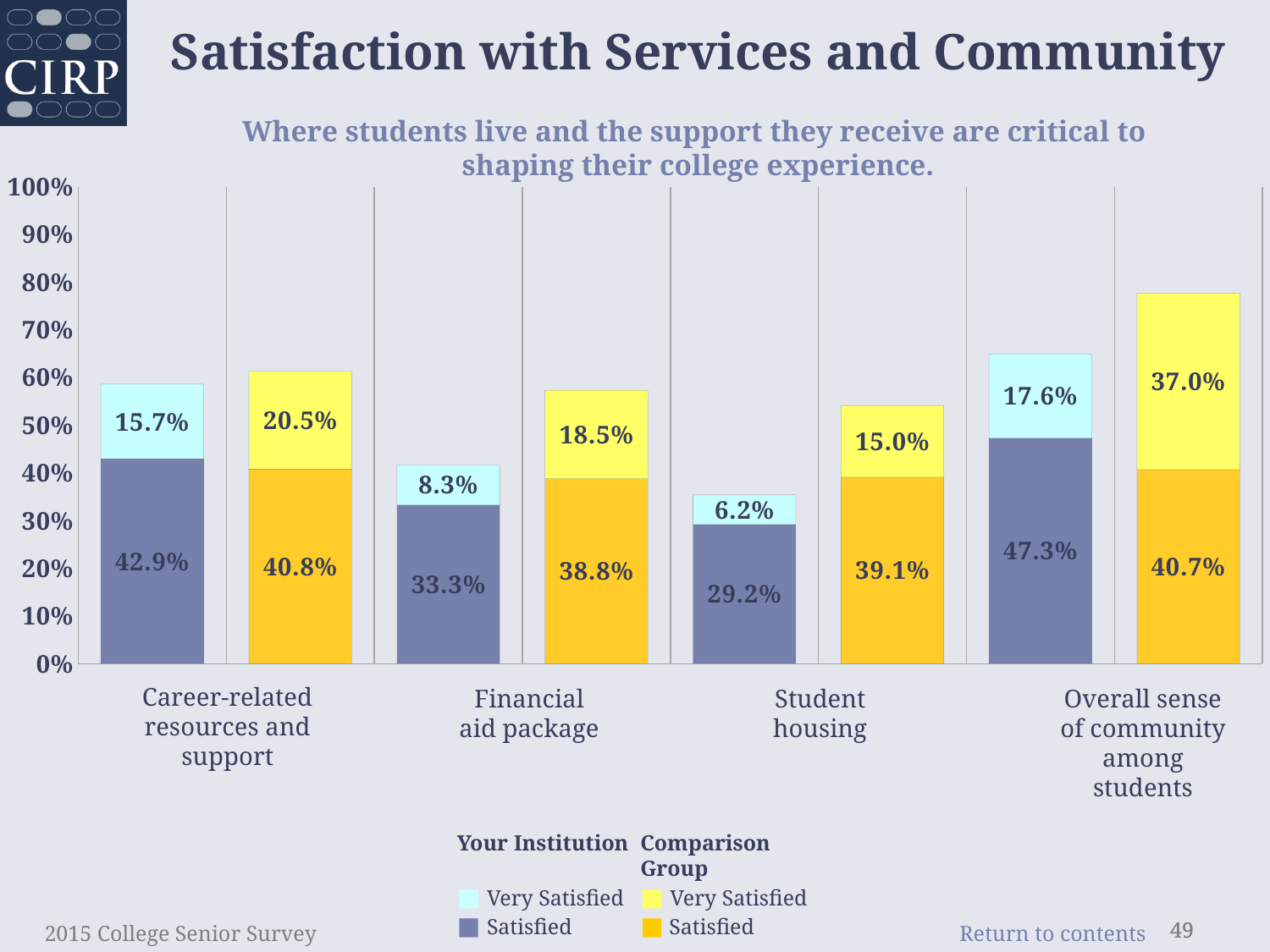
What percentage of Your Institution students were Very Satisfied with Career-related resources and support? 15.7% What is the total height of the Your Institution stacked bar for Career-related resources and support? 58.6% What percentage of the Comparison Group was Satisfied with the Financial aid package? 38.8% How many categories are shown on the x axis of the chart? 4 How many series does the legend list? 4 What is the total height of the Comparison Group stacked bar for Overall sense of community among students? 77.7% Which category has the highest Comparison Group Very Satisfied percentage? Overall sense of community among students What percentage of Your Institution students were Satisfied with Student housing? 29.2% Which is larger for Student housing: the Your Institution Satisfied percentage or the Comparison Group Satisfied percentage? Comparison Group Satisfied (39.1%) What kind of chart is shown on the slide? Stacked bar chart What is the difference between the Comparison Group and Your Institution Very Satisfied percentages for Overall sense of community among students? 19.4% Which category has the lowest Your Institution Very Satisfied percentage? Student housing